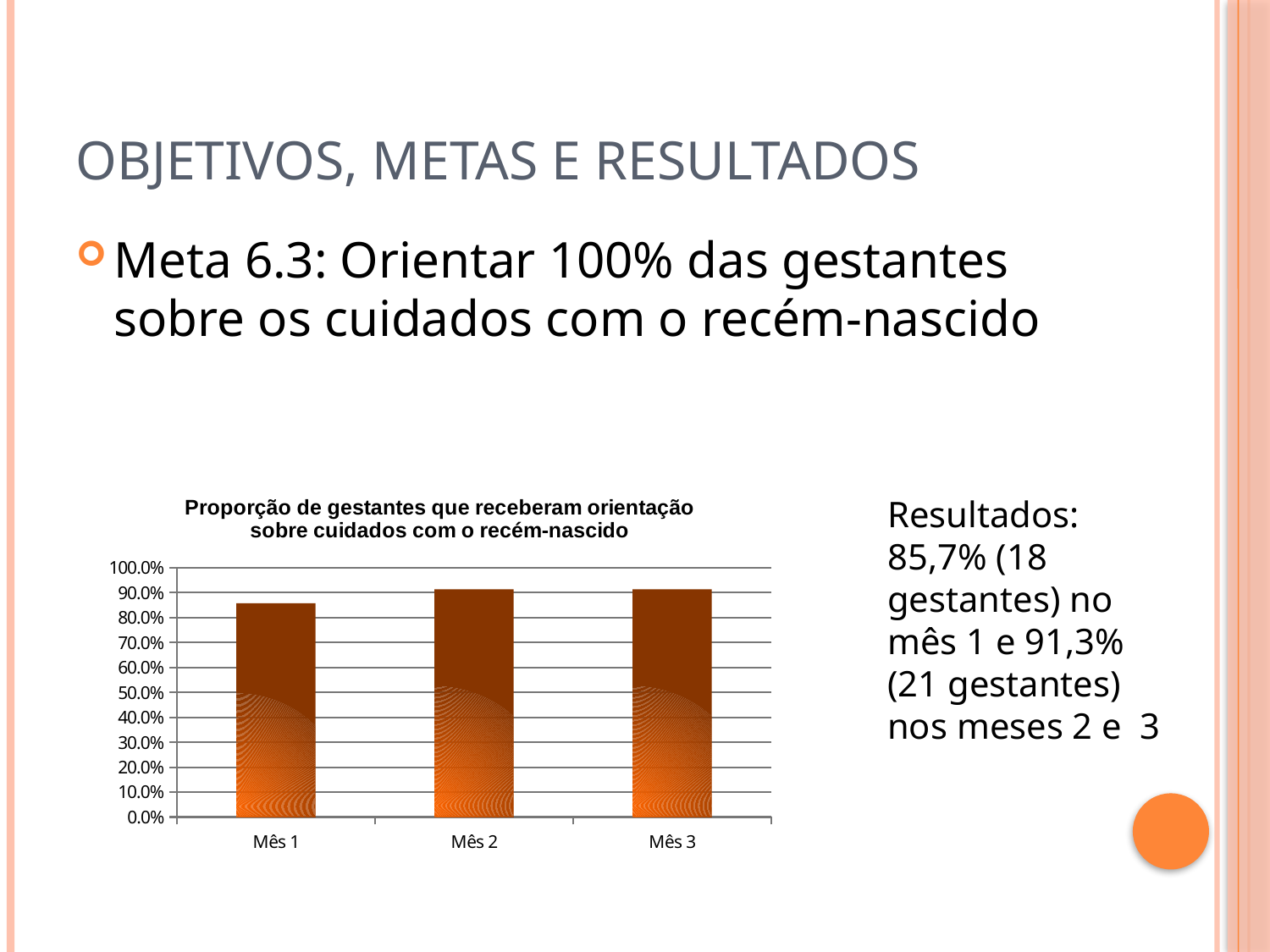
What is the highest value shown on the y axis of the chart? 100.0% Which is larger, the value for Mês 1 or the value for Mês 2? Mês 2 Is the value for Mês 2 greater or less than 90.0%? greater Is the value for Mês 3 greater or less than 80.0%? greater Is the value for Mês 1 greater or less than 90.0%? less Which month has the lowest proportion in the chart? Mês 1 According to the slide, what proportion of pregnant women received guidance in mês 2 and mês 3? 91,3% Does the proportion rise or fall from Mês 1 to Mês 2? rise What kind of chart is shown on the slide? Bar chart What is the title of the chart? Proporção de gestantes que receberam orientação sobre cuidados com o recém-nascido According to the slide, what proportion of pregnant women received guidance in mês 1? 85,7% How many categories (months) are plotted on the x axis of the chart? 3